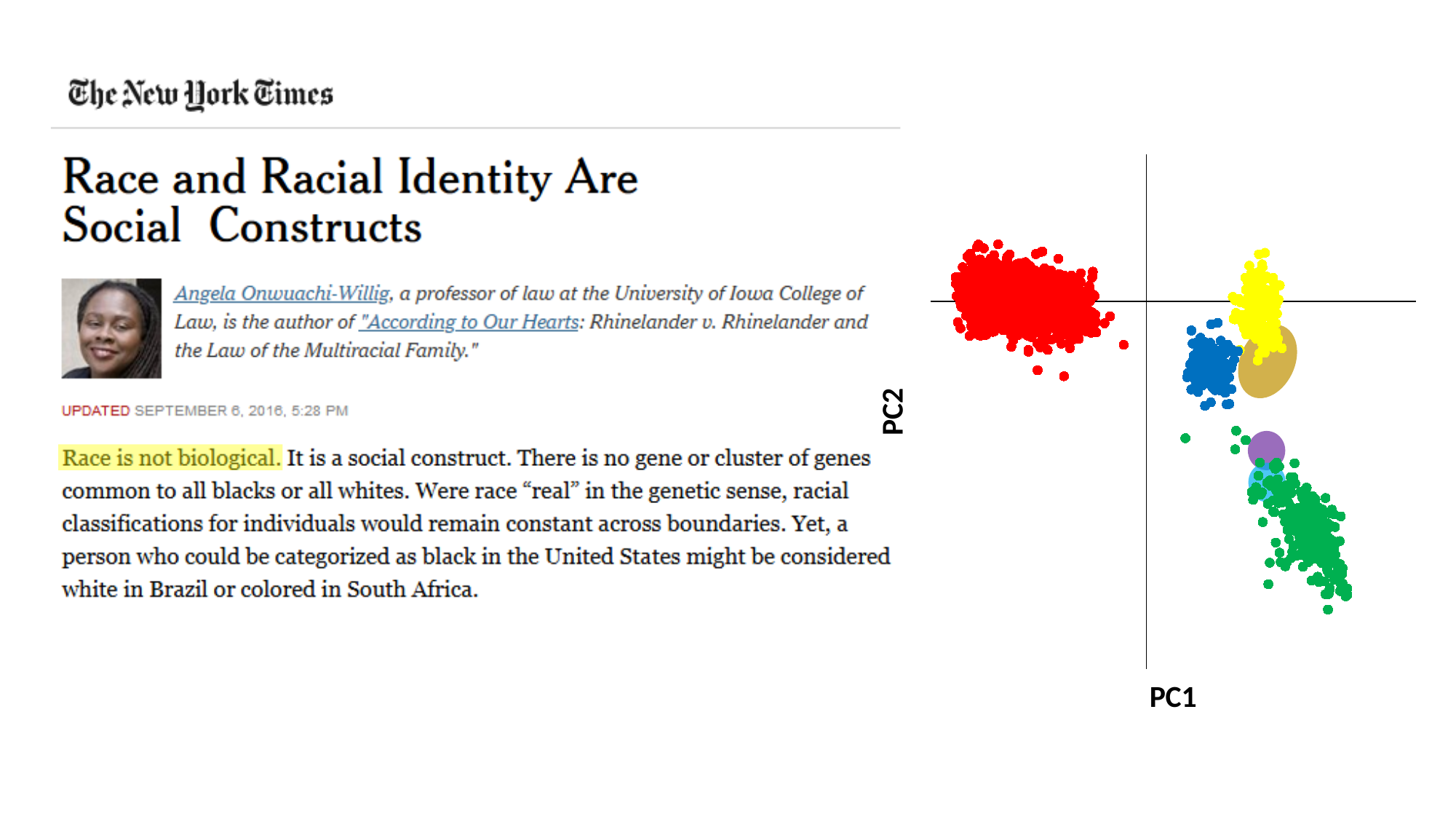
In the scatter plot, which cluster is positioned higher on PC2, the yellow cluster or the green cluster? yellow In the scatter plot, which cluster is positioned further left on PC1, the blue cluster or the yellow cluster? blue What is the label of the horizontal axis of the scatter plot? PC1 Which coloured cluster in the scatter plot extends lowest along the PC2 axis? green What kind of chart is shown on the right side of the slide? scatter plot What is the label of the vertical axis of the scatter plot? PC2 In the scatter plot, which cluster is positioned further right on PC1, the red cluster or the green cluster? green